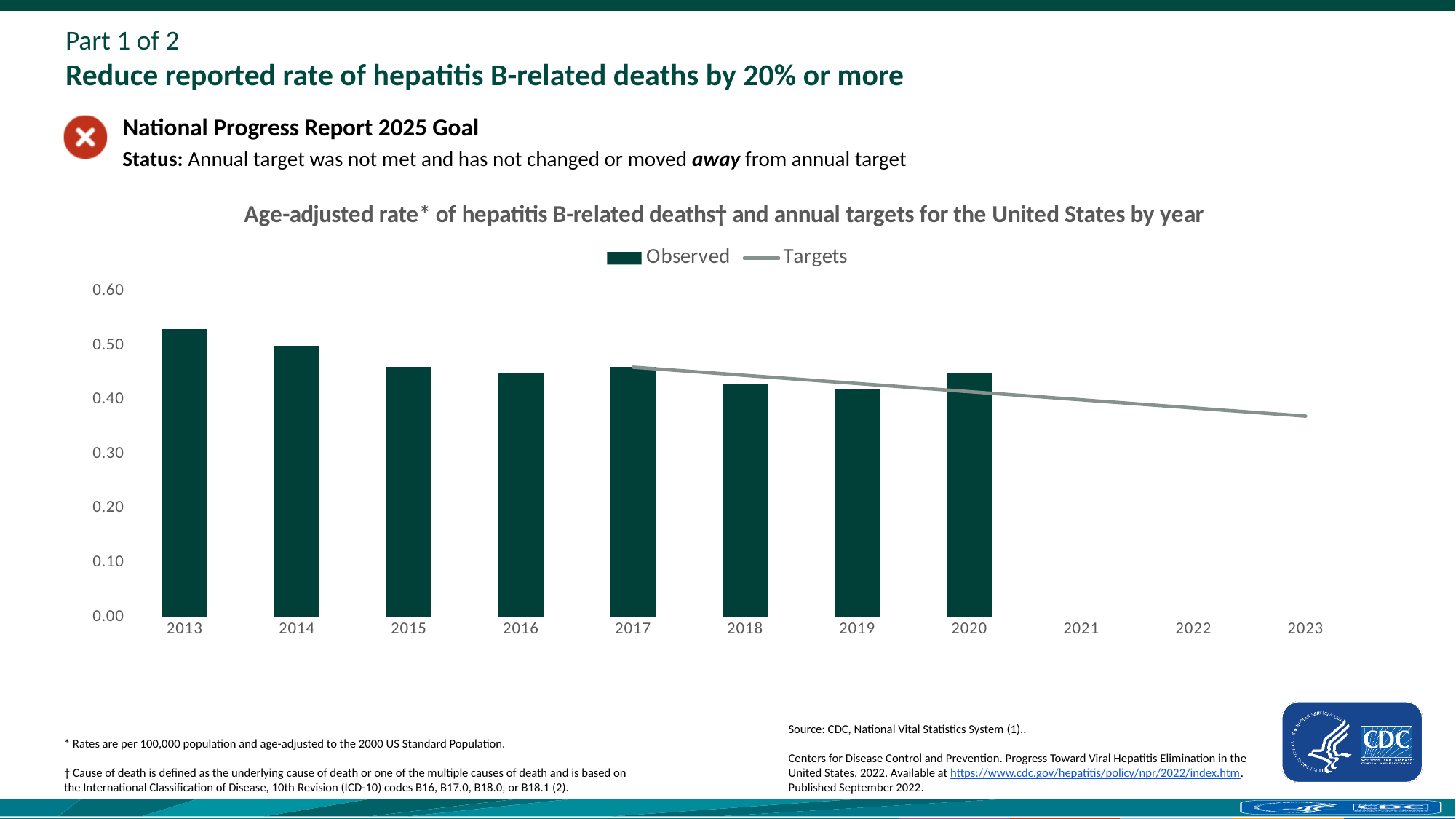
How many years have an Observed bar plotted in the chart? 8 Is the Observed value for 2013 greater or less than 0.50? greater Does the Targets line rise or fall from 2017 to 2023? Fall What is the title of the chart? Age-adjusted rate* of hepatitis B-related deaths† and annual targets for the United States by year Is the Observed value for 2019 greater or less than 0.40? greater How many years are labelled on the x axis of the chart? 11 How many series does the chart legend list? 2 Is the Observed value for 2018 greater or less than 0.50? less What are the two series named in the chart legend? Observed and Targets Which is larger, the Observed value for 2013 or for 2020? 2013 Which year has the highest Observed rate in the chart? 2013 What kind of chart is shown on the slide? Combination bar and line chart